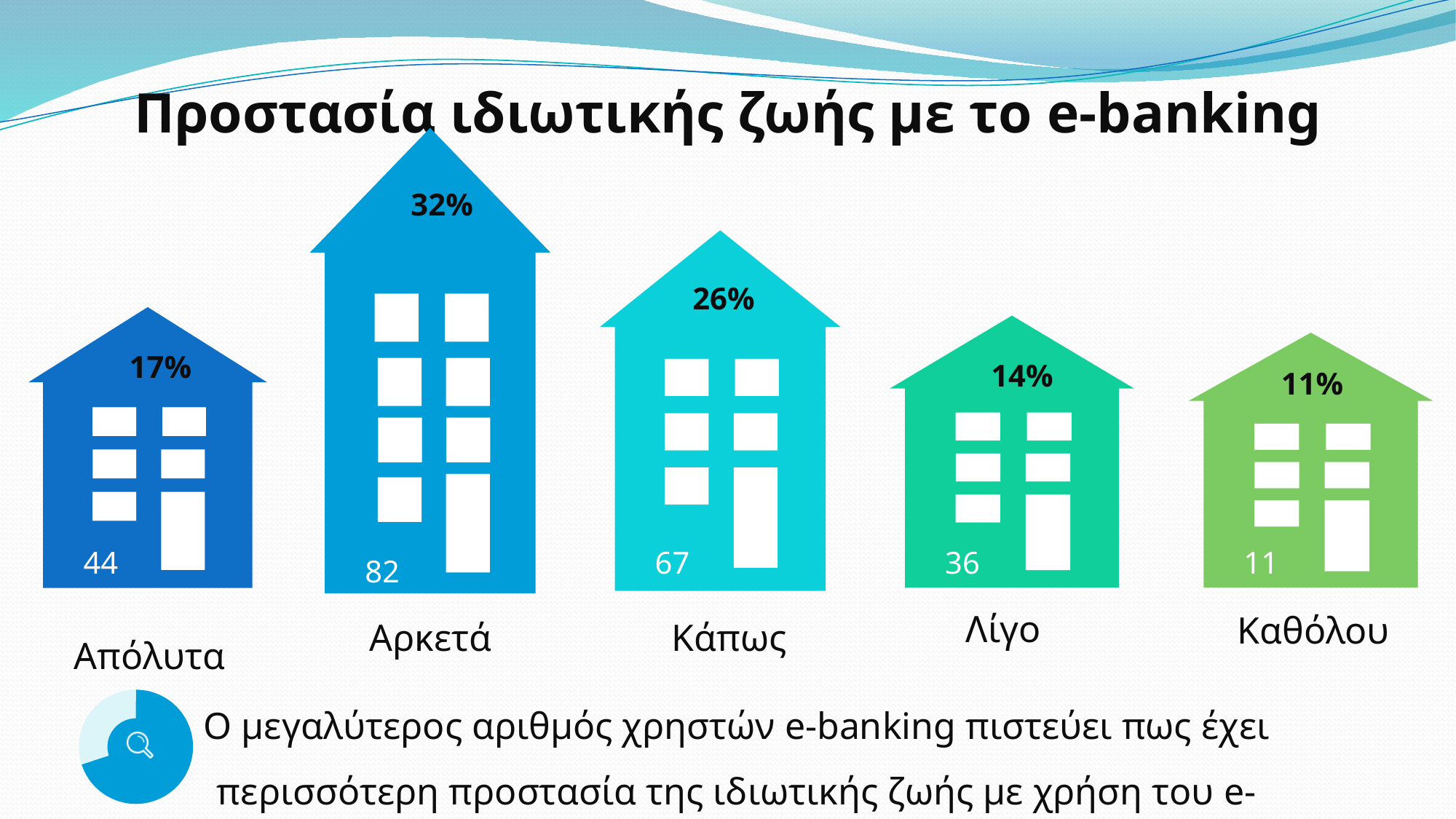
Which category has the lowest count? Καθόλου Which has a higher percentage, Απόλυτα or Λίγο? Απόλυτα How many categories are shown in the chart? 5 What count is shown inside the house for Απόλυτα? 44 What is the difference in percentage points between Αρκετά and Κάπως? 6 What is the title of the slide? Προστασία ιδιωτικής ζωής με το e-banking What percentage is shown for Καθόλου? 11% What is the difference between the counts for Απόλυτα and Λίγο? 8 What percentage is shown for Αρκετά? 32% Which category has the highest percentage? Αρκετά What is the total of the counts shown across all five houses? 240 What count is shown inside the house for Κάπως? 67